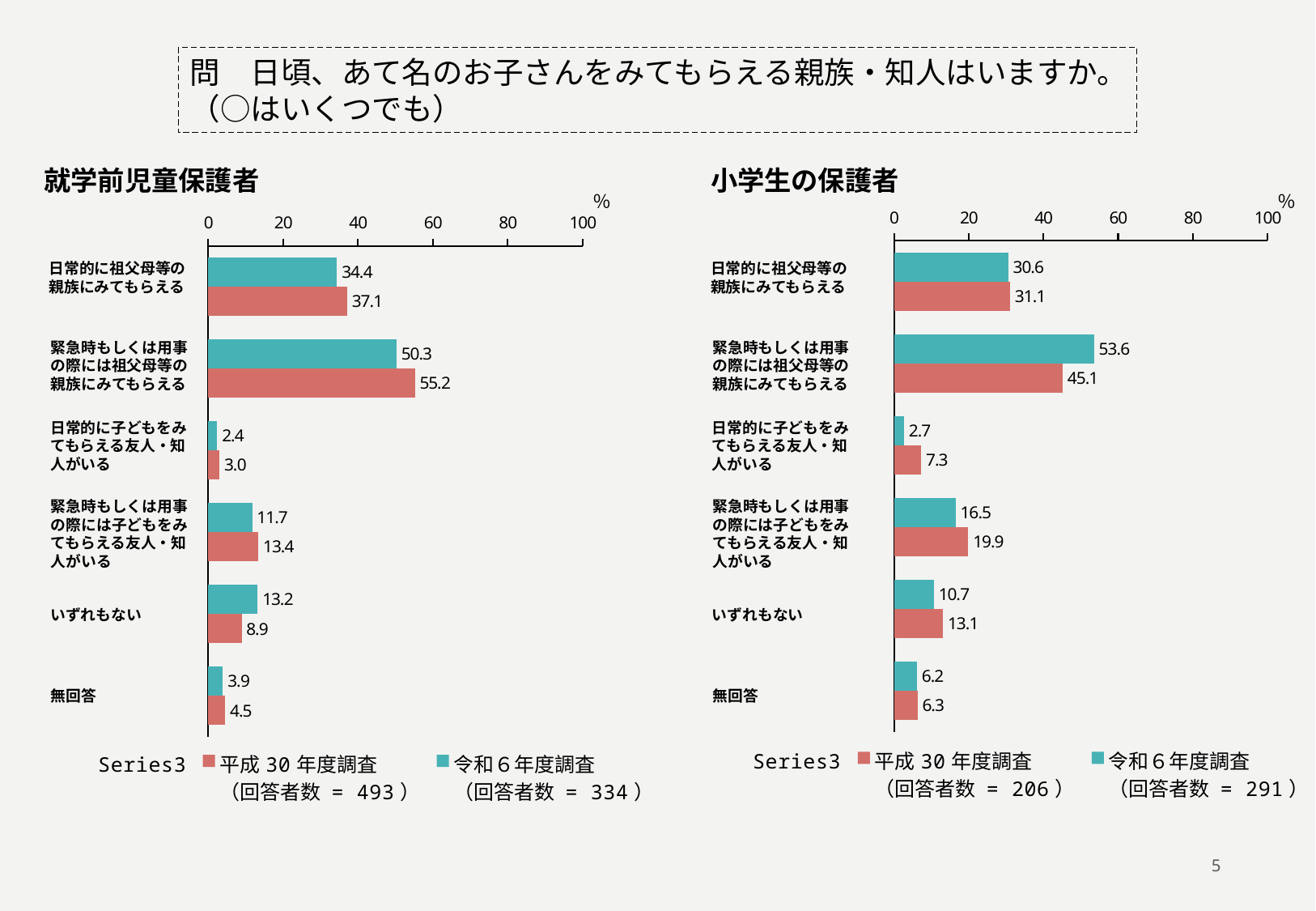
In the 就学前児童保護者 chart, what is the 平成30年度調査 value for 緊急時もしくは用事の際には祖父母等の親族にみてもらえる? 55.2 In the 小学生の保護者 chart, what is the 平成30年度調査 value for 日常的に子どもをみてもらえる友人・知人がいる? 7.3 In the 就学前児童保護者 chart, what is the 令和６年度調査 value for 日常的に祖父母等の親族にみてもらえる? 34.4 How many categories are shown in the 就学前児童保護者 chart? 6 According to the legend of the 小学生の保護者 chart, how many respondents were in the 令和６年度調査? 291 In the 就学前児童保護者 chart, what is the 平成30年度調査 value for 無回答? 4.5 In the 小学生の保護者 chart, is the 令和６年度調査 value for 緊急時もしくは用事の際には祖父母等の親族にみてもらえる greater or less than 40? greater In the 就学前児童保護者 chart, which is larger for いずれもない: the 平成30年度調査 value or the 令和６年度調査 value? 令和６年度調査 What kind of chart is the 小学生の保護者 chart? bar chart In the 就学前児童保護者 chart, which category has the lowest 令和６年度調査 value? 日常的に子どもをみてもらえる友人・知人がいる In the 小学生の保護者 chart, which category has the highest 令和６年度調査 value? 緊急時もしくは用事の際には祖父母等の親族にみてもらえる In the 小学生の保護者 chart, what is the difference between the 令和６年度調査 and 平成30年度調査 values for 緊急時もしくは用事の際には祖父母等の親族にみてもらえる? 8.5